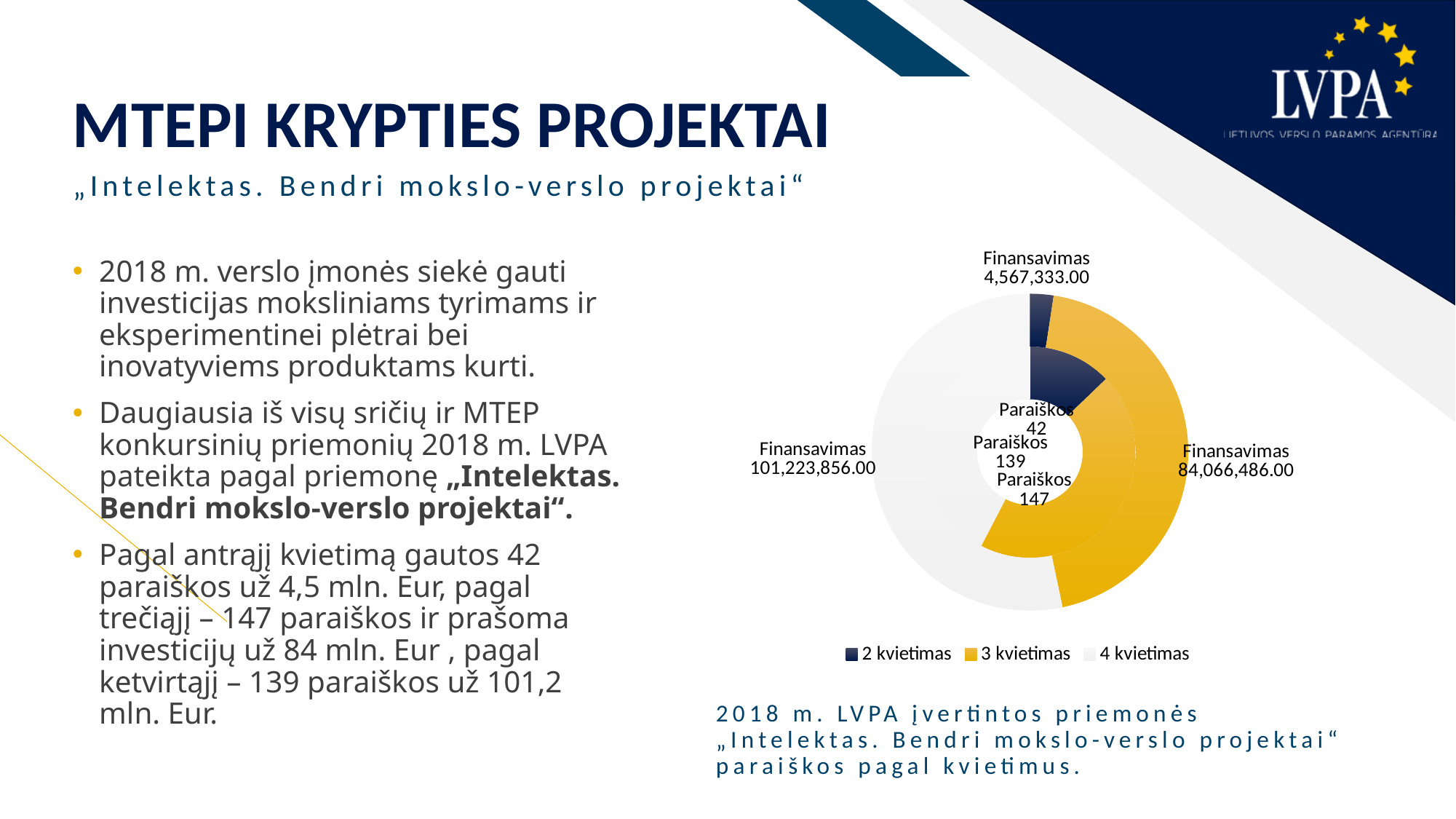
What is the total number of applications (Paraiškos) across all three kvietimas? 328 What kind of chart is shown on the slide? Doughnut chart How many series does the legend list? 3 What is the difference in Finansavimas between 4 kvietimas and 3 kvietimas? 17,157,370.00 How many applications (Paraiškos) are shown for 3 kvietimas? 147 How many applications (Paraiškos) are shown for 2 kvietimas? 42 Which kvietimas has the lowest number of applications (Paraiškos)? 2 kvietimas Which kvietimas has the highest Finansavimas value? 4 kvietimas What is the difference in the number of applications between 3 kvietimas and 4 kvietimas? 8 What is the Finansavimas value for 4 kvietimas? 101,223,856.00 Which has more applications, 3 kvietimas or 4 kvietimas? 3 kvietimas What is the Finansavimas value for 3 kvietimas? 84,066,486.00